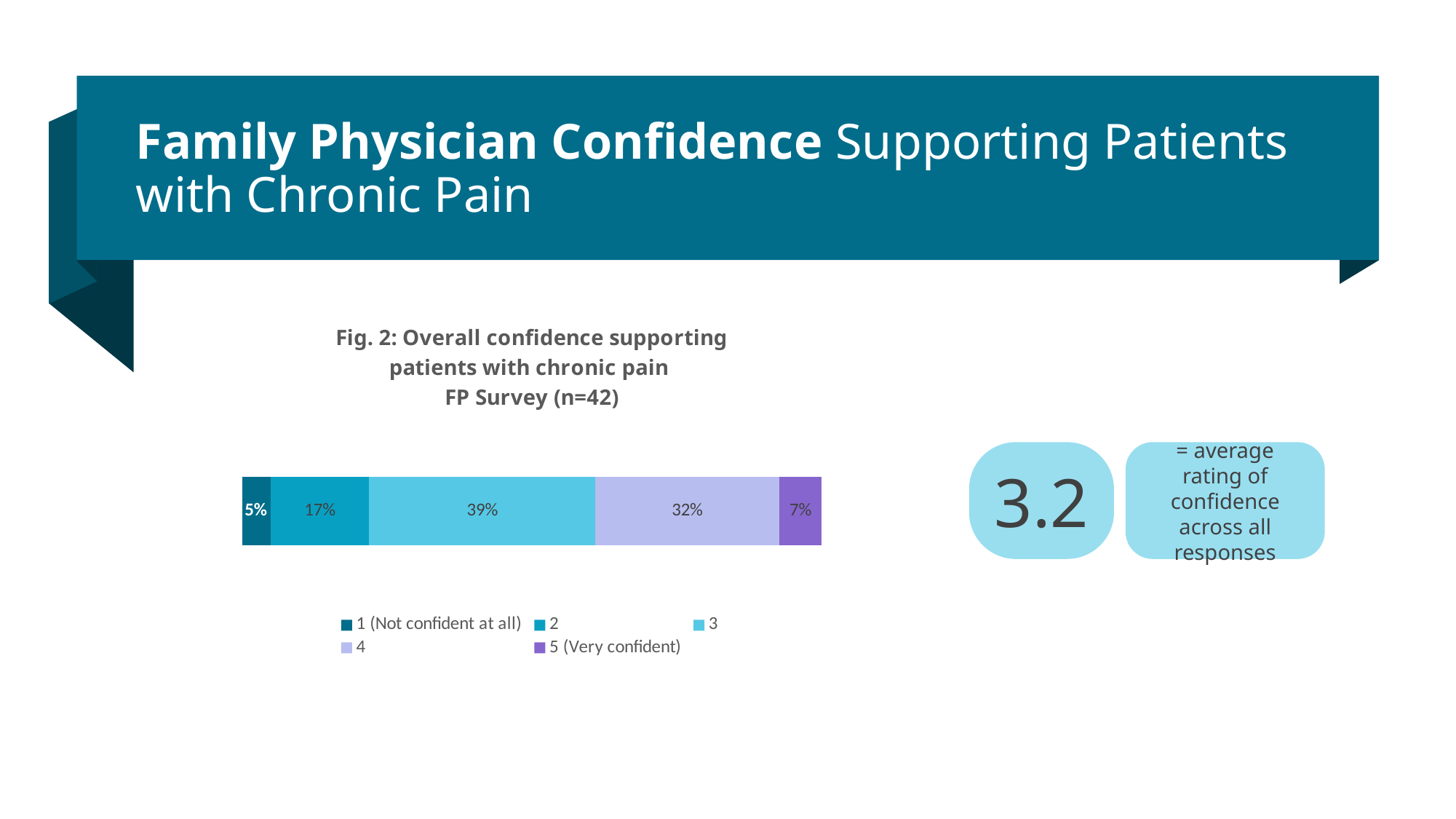
What percentage of respondents chose 1 (Not confident at all)? 5% What percentage of respondents rated their confidence as 3? 39% Which is larger, the share for rating 2 or the share for rating 5 (Very confident)? 2 What percentage of respondents chose 5 (Very confident)? 7% What is the average confidence rating across all responses shown on the slide? 3.2 Which confidence rating has the largest share of responses? 3 What is the difference between the share for rating 3 and the share for rating 4? 7% What kind of chart is shown in Fig. 2? Stacked bar chart What percentage of respondents rated their confidence as 4? 32% Which confidence rating has the smallest share of responses? 1 (Not confident at all) What is the total of the stacked bar? 100% How many series does the legend list? 5